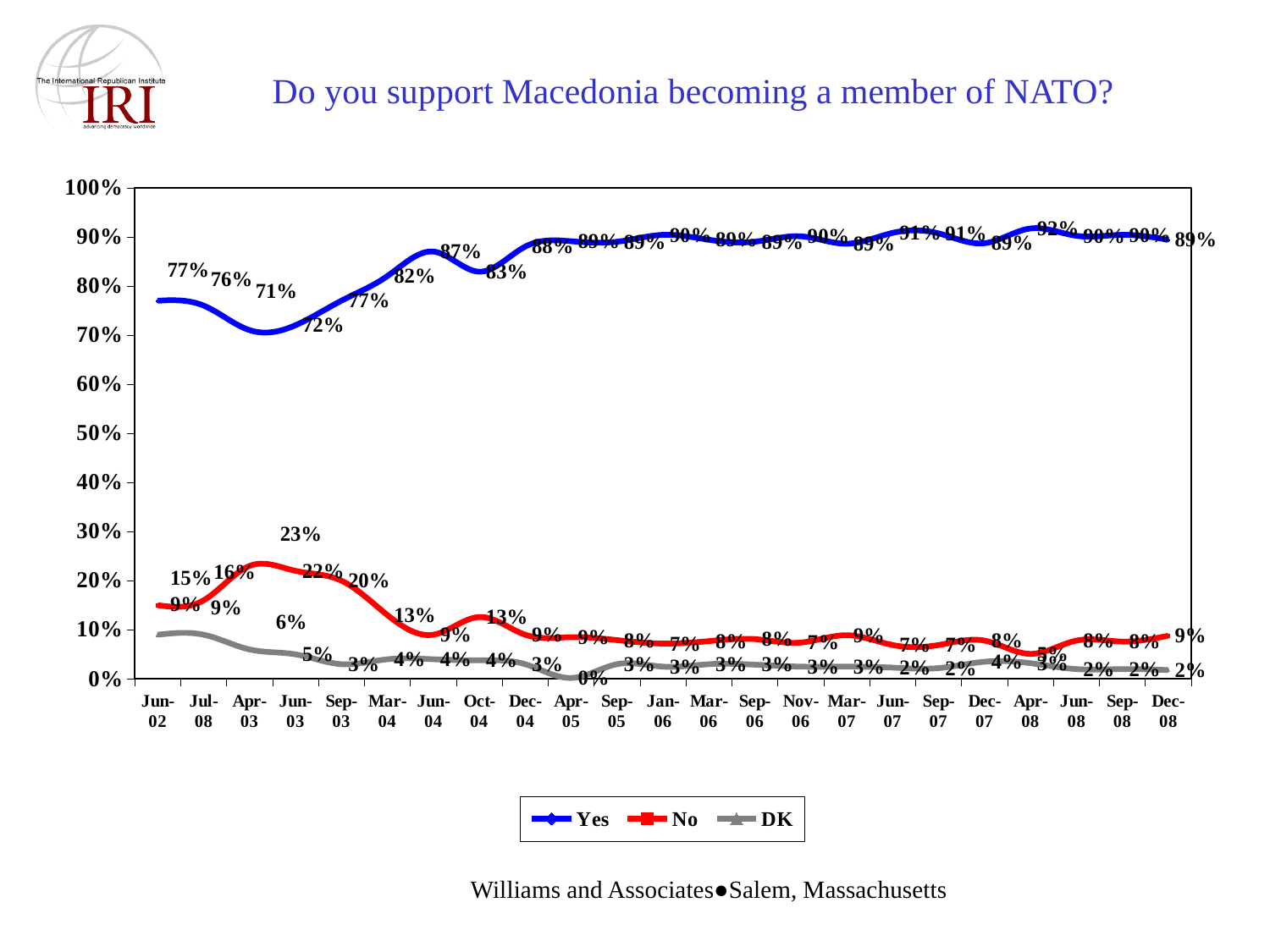
What is the highest value reached by the No series? 23% What kind of chart is shown on the slide? Line chart At which date does the Yes series reach its highest value? Apr-08 What is the value of the Yes series for Jun-02? 77% Does the Yes series rise or fall overall from Jun-02 to Dec-08? Rise What is the value of the No series for Apr-03? 23% How many series does the legend list? 3 What is the value of the DK series for Apr-05? 0% What is the difference between the Yes and No values for Dec-08? 80 percentage points Which is larger, the No value for Apr-03 or the No value for Jun-03? Apr-03 How many survey dates are plotted along the x axis? 23 At which date does the Yes series reach its lowest value? Apr-03